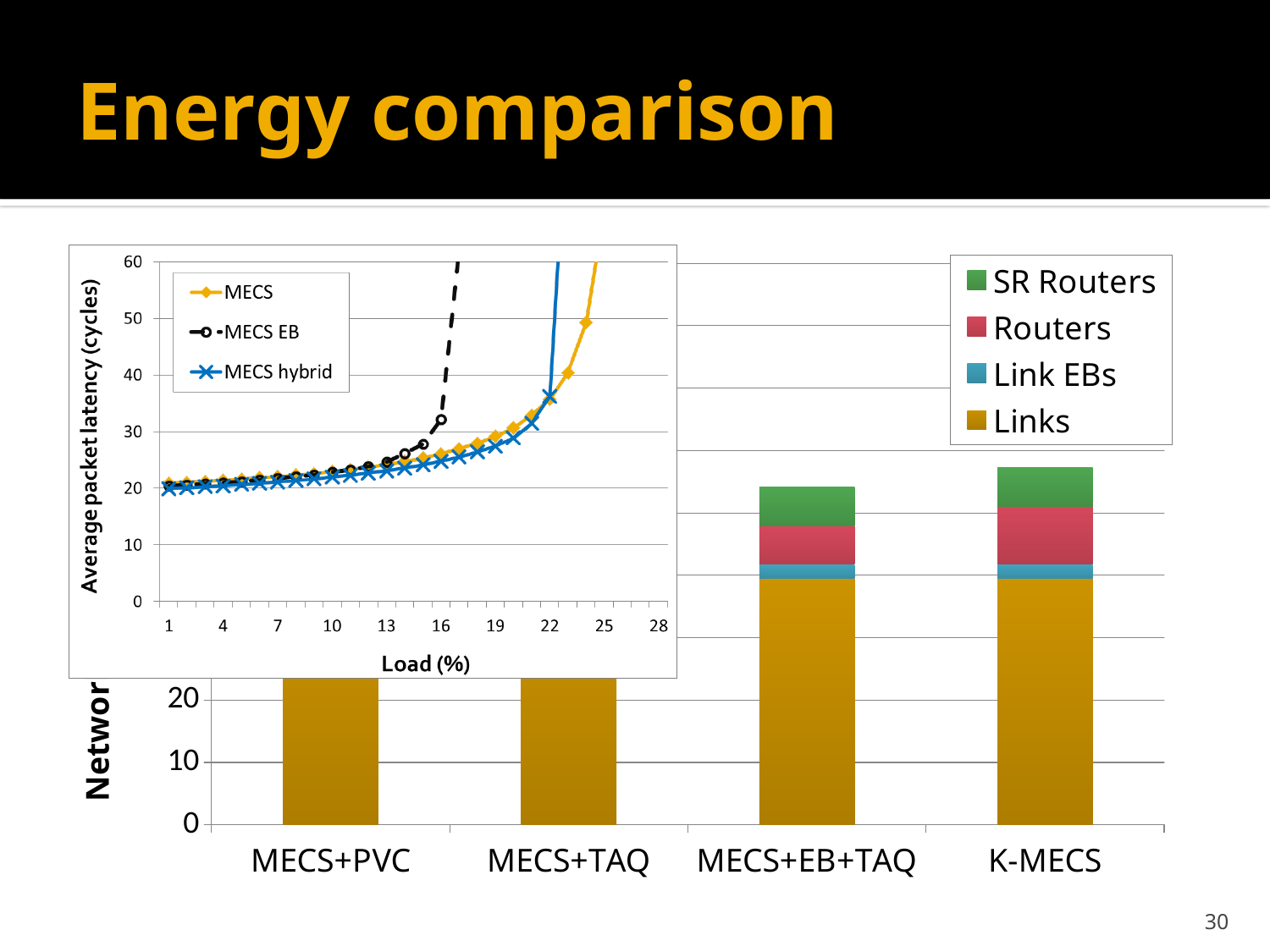
What kind of chart is the larger chart at the bottom of the slide with categories MECS+PVC, MECS+TAQ, MECS+EB+TAQ and K-MECS? Stacked bar chart How many series does the legend of the bottom bar chart list? 4 In the bottom bar chart, which series is shown in green in the legend? SR Routers In the bottom bar chart, is the total value for MECS+EB+TAQ greater or less than 20? greater In the inset line chart, is the MECS latency at a load of 1% greater or less than 30 cycles? less In the inset line chart, which series shows its latency rising sharply at the lowest load? MECS EB How many categories are shown on the x axis of the bottom bar chart? 4 What kind of chart is the inset chart at the top left with the x axis labelled Load (%)? Line chart In the inset line chart, does average packet latency rise or fall as load increases? Rise How many series does the legend of the inset line chart list? 3 In the bottom bar chart, which category has the tallest stacked bar among MECS+EB+TAQ and K-MECS? K-MECS In the bottom bar chart, is the Routers segment larger for K-MECS or for MECS+EB+TAQ? K-MECS